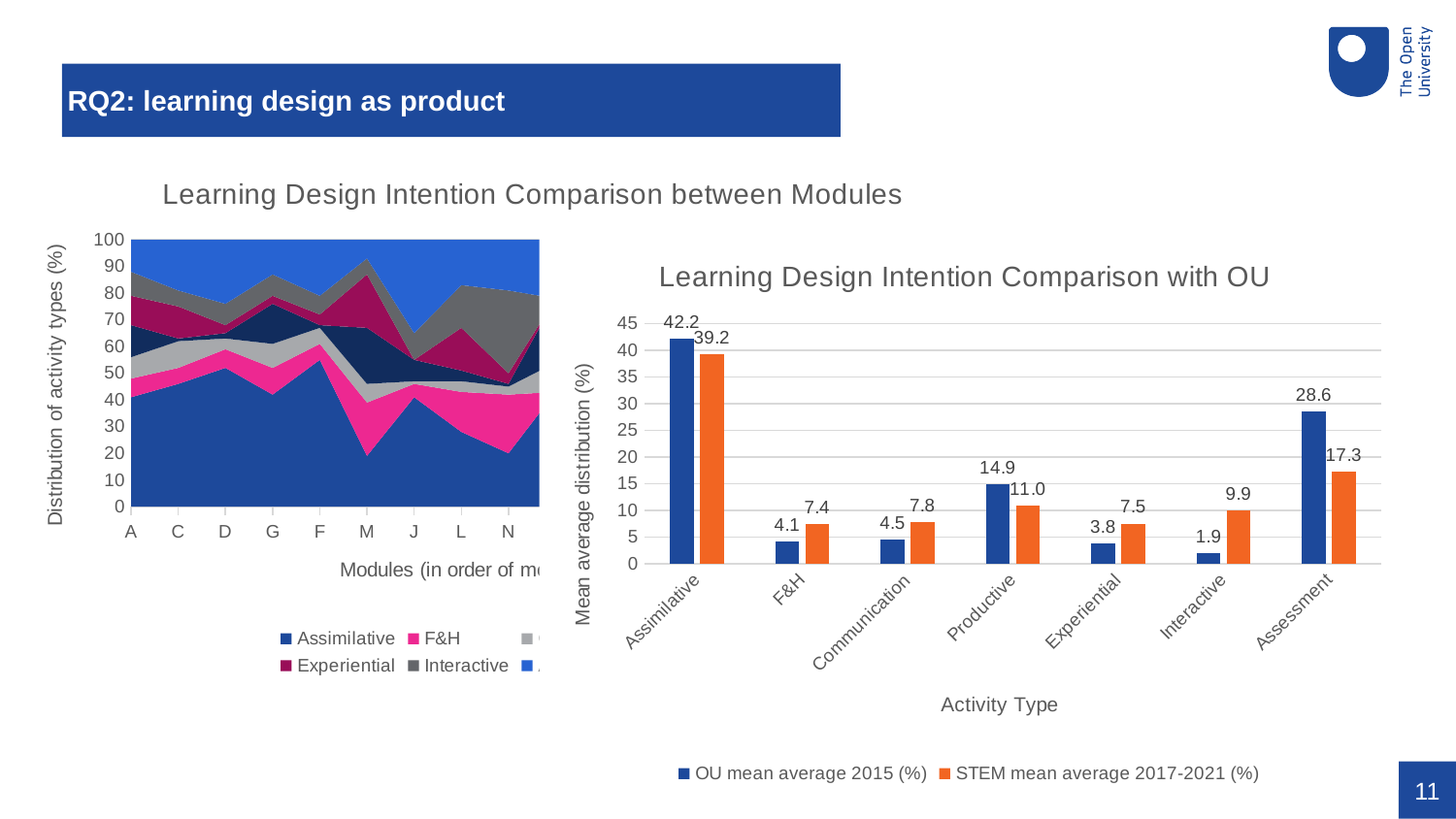
In the 'Learning Design Intention Comparison with OU' chart, how many activity types are shown on the x axis? 7 In the 'Learning Design Intention Comparison with OU' chart, what is the STEM mean average 2017-2021 (%) value for Interactive? 9.9 In the 'Learning Design Intention Comparison with OU' chart, what is the difference between the OU mean average 2015 (%) and the STEM mean average 2017-2021 (%) for Assessment? 11.3 In the 'Learning Design Intention Comparison with OU' chart, how many series does the legend list? 2 In the 'Learning Design Intention Comparison with OU' chart, which is larger for Productive: the OU mean average 2015 (%) or the STEM mean average 2017-2021 (%)? OU mean average 2015 (%) In the 'Learning Design Intention Comparison with OU' chart, what is the STEM mean average 2017-2021 (%) value for Assessment? 17.3 What is the y-axis label of the 'Learning Design Intention Comparison with OU' chart? Mean average distribution (%) What kind of chart is 'Learning Design Intention Comparison with OU'? Bar chart In the 'Learning Design Intention Comparison with OU' chart, which activity type has the highest STEM mean average 2017-2021 (%) value? Assimilative In the 'Learning Design Intention Comparison with OU' chart, which activity type has the lowest OU mean average 2015 (%) value? Interactive In the 'Learning Design Intention Comparison with OU' chart, what is the OU mean average 2015 (%) value for Assimilative? 42.2